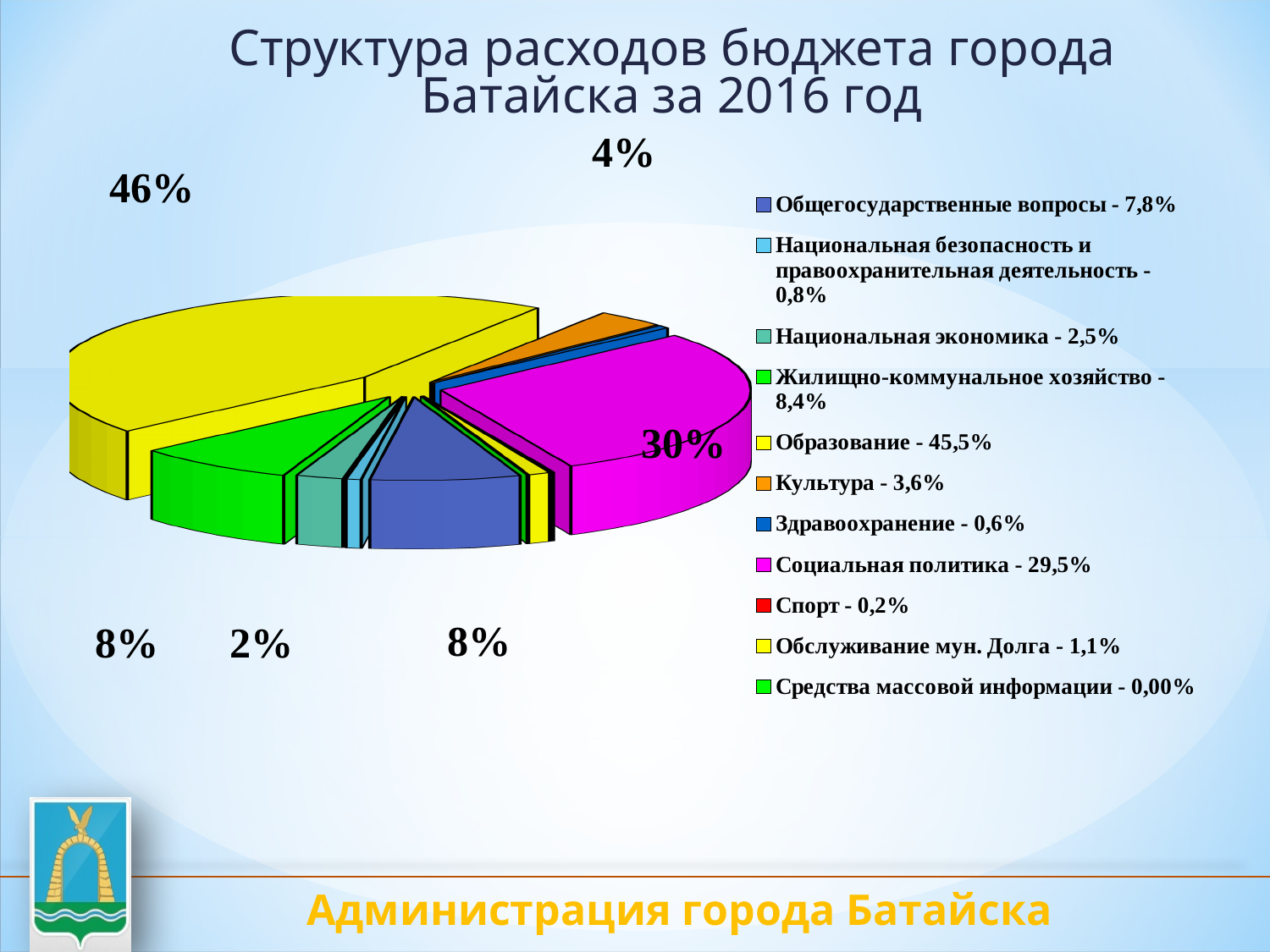
According to the legend, what share of expenditure goes to Здравоохранение? 0,6% Which category has the largest share of the budget expenditure? Образование According to the legend, what share of expenditure goes to Культура? 3,6% Which category has the smallest share of the budget expenditure? Средства массовой информации What data label is printed next to the largest yellow slice of the pie? 46% By how many percentage points does the share for Образование exceed the share for Социальная политика? 16% Which is larger: the share for Жилищно-коммунальное хозяйство or for Общегосударственные вопросы? Жилищно-коммунальное хозяйство What is the title of the slide containing the pie chart? Структура расходов бюджета города Батайска за 2016 год According to the legend, what share of expenditure goes to Образование? 45,5% How many categories does the legend of the pie chart list? 11 According to the legend, what share of expenditure goes to Социальная политика? 29,5% What kind of chart is shown on the slide? pie chart